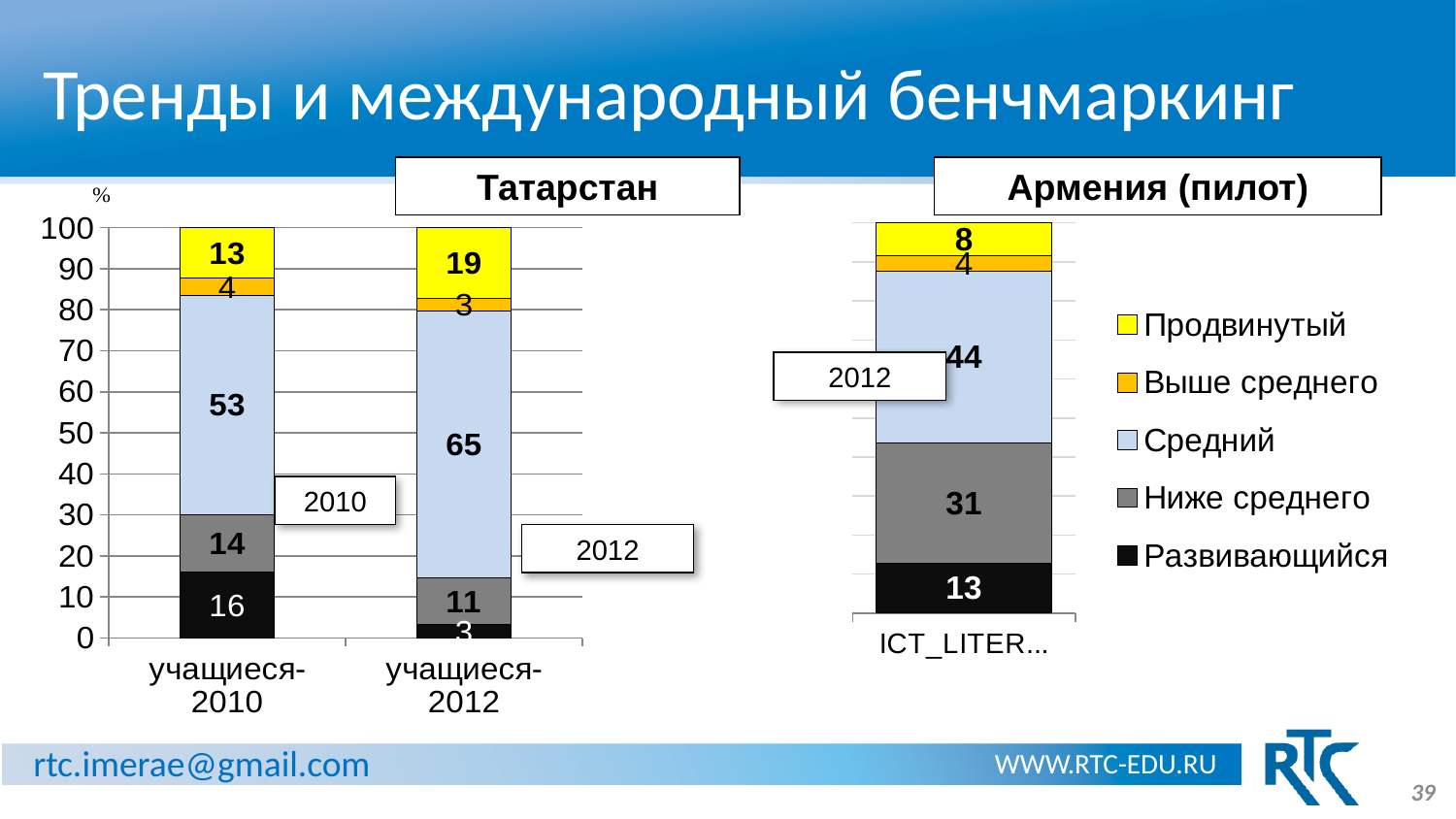
In the Татарстан chart, what is the value of the Развивающийся segment for учащиеся-2010? 16 In the Армения (пилот) chart, what is the value of the Ниже среднего segment? 31 In the Армения (пилот) chart, what is the value of the Продвинутый segment? 8 In the legend, what colour represents the Продвинутый series? Yellow How many series does the legend on the slide list? 5 In the Армения (пилот) chart, what is the total of all segments in the bar? 100 In the Татарстан chart, how many stacked bars are shown? 2 In the Татарстан chart, by how much did the Средний segment increase from учащиеся-2010 to учащиеся-2012? 12 In the Татарстан chart, which bar has the larger Продвинутый segment, учащиеся-2010 or учащиеся-2012? учащиеся-2012 In the Татарстан chart, by how much is the Развивающийся segment for учащиеся-2010 larger than for учащиеся-2012? 13 What type of chart is the Татарстан chart? Stacked bar chart In the Татарстан chart, what is the value of the Средний segment for учащиеся-2012? 65